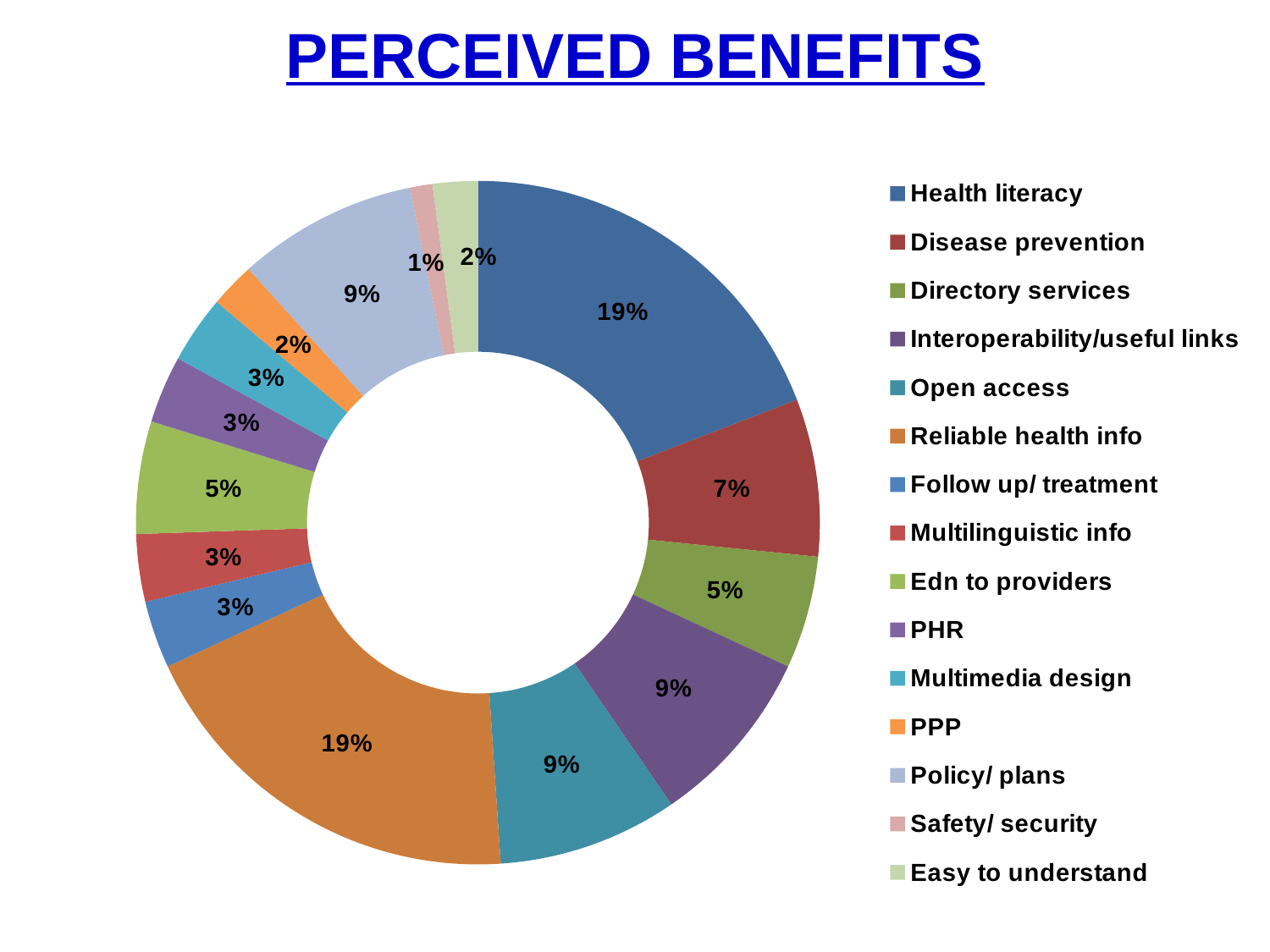
What share of the chart does Health literacy account for? 19% Which category has the smallest share of the chart? Safety/ security What percentage is shown for Reliable health info? 19% What percentage is shown for PPP? 2% How many categories are shown in the chart? 15 What percentage is shown for Policy/ plans? 9% Which has a larger share, Directory services or Interoperability/useful links? Interoperability/useful links What is the title of the slide? PERCEIVED BENEFITS What is the difference in percentage points between Health literacy and Disease prevention? 12 What kind of chart is shown on the slide? doughnut chart What percentage is shown for Disease prevention? 7% What is the difference in percentage points between Open access and Edn to providers? 4